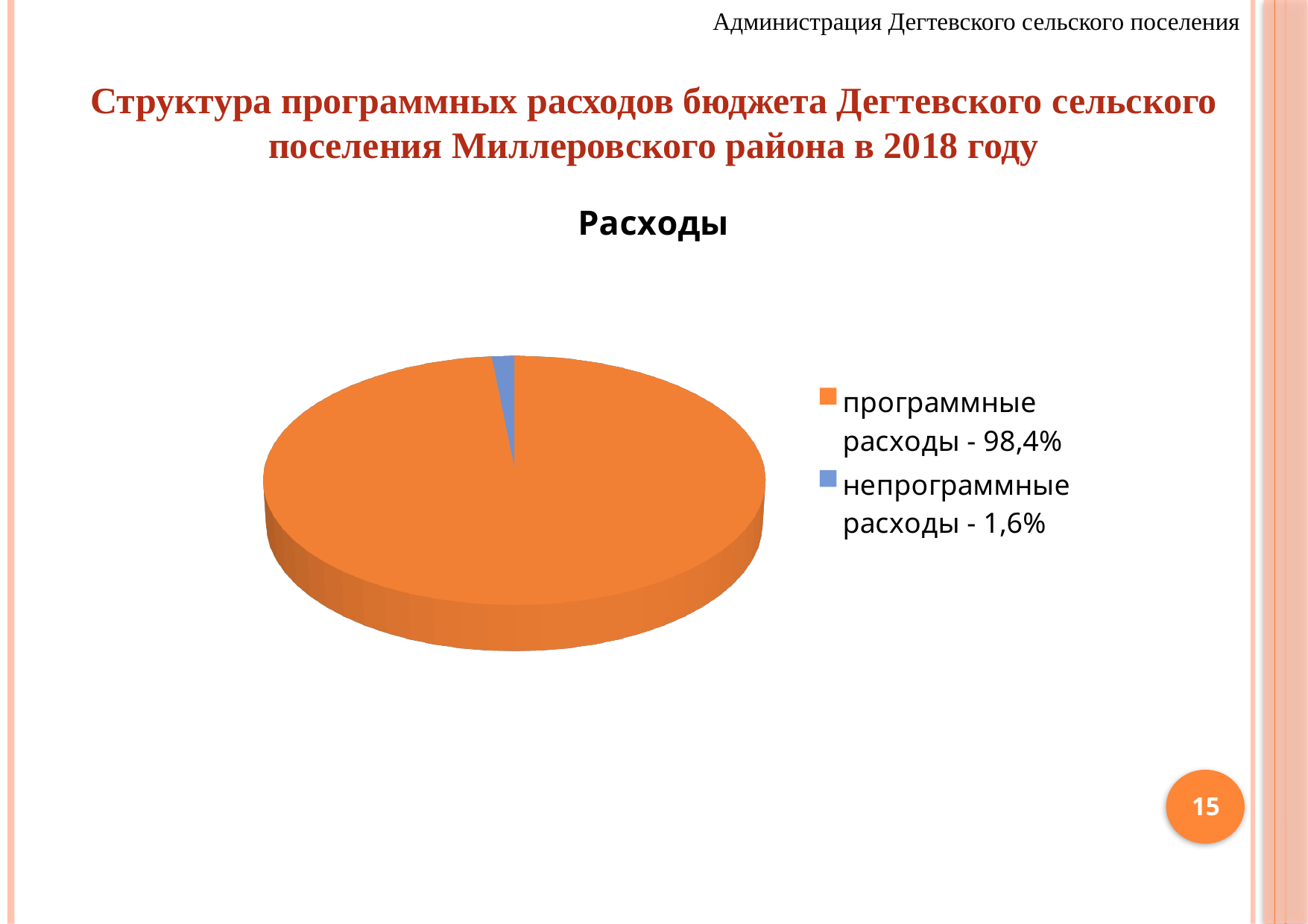
What share of the pie is 'программные расходы'? 98,4% What colour is the slice for 'непрограммные расходы'? blue Which slice is the smallest? непрограммные расходы How many entries does the legend list? 2 How many slices does the pie chart have? 2 Which is larger: 'программные расходы' or 'непрограммные расходы'? программные расходы What kind of chart is shown on the slide? pie chart What is the difference between the shares of 'программные расходы' and 'непрограммные расходы'? 96,8% What is the title of the chart? Расходы What share of the pie is 'непрограммные расходы'? 1,6% Which slice is the largest? программные расходы